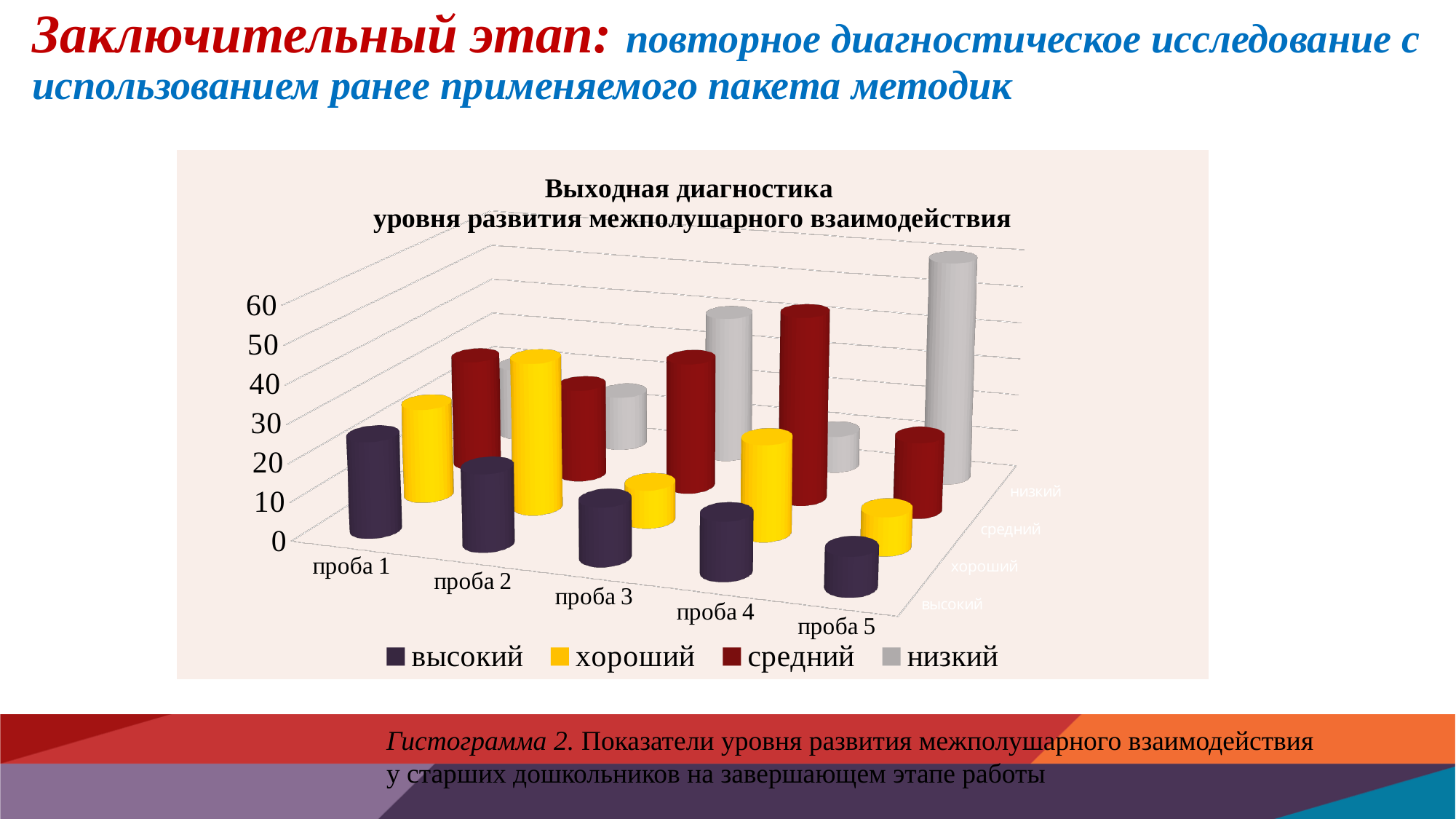
Which category has the highest value in the высокий series? проба 1 How many series does the chart legend list? 4 Which series has the tallest bar for проба 5? низкий How many categories (пробы) are shown on the x axis of the chart? 5 Which category has the highest value in the низкий series? проба 5 Which category has the lowest value in the высокий series? проба 5 What kind of chart is shown on the slide? bar chart What is the title of the chart? Выходная диагностика уровня развития межполушарного взаимодействия Is the высокий value for проба 1 greater or less than 40? less Do the values of the высокий series rise or fall from проба 1 to проба 5? fall What are the four series listed in the chart legend? высокий, хороший, средний, низкий For проба 1, which is larger: the высокий value or the средний value? средний